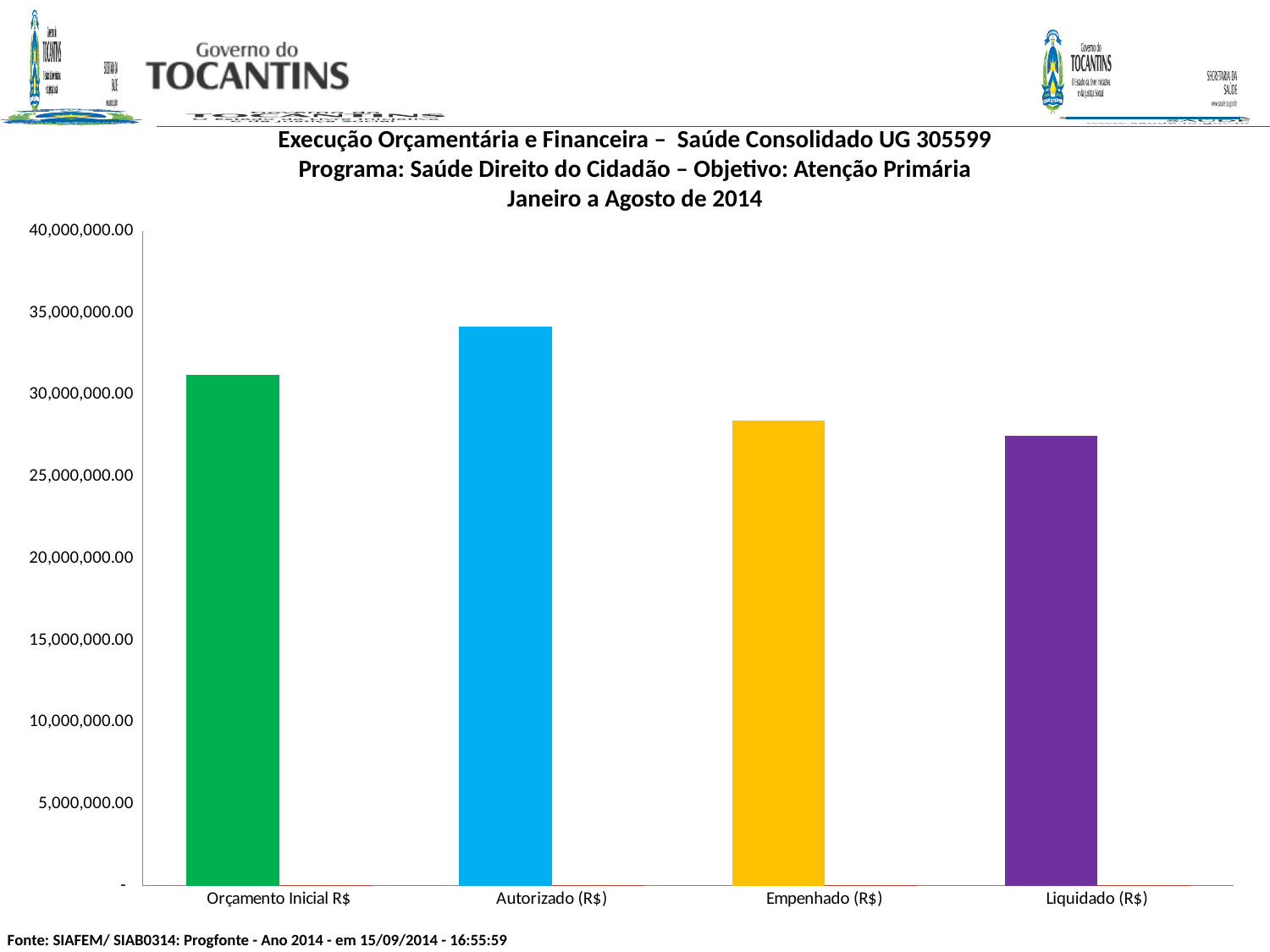
Which category has the highest value? Autorizado (R$) Is the value for Empenhado (R$) greater or less than 25,000,000.00? greater Is the value for Liquidado (R$) greater or less than 30,000,000.00? less What period does the chart title say the data covers? Janeiro a Agosto de 2014 Is the value for Orçamento Inicial R$ greater or less than 30,000,000.00? greater How many categories are plotted on the x axis? 4 What kind of chart is shown on the slide? Bar chart Do the values rise or fall from Autorizado (R$) to Liquidado (R$) along the x axis? fall Which is larger, Orçamento Inicial R$ or Autorizado (R$)? Autorizado (R$) Which category has the lowest value? Liquidado (R$) Which is larger, Empenhado (R$) or Liquidado (R$)? Empenhado (R$)